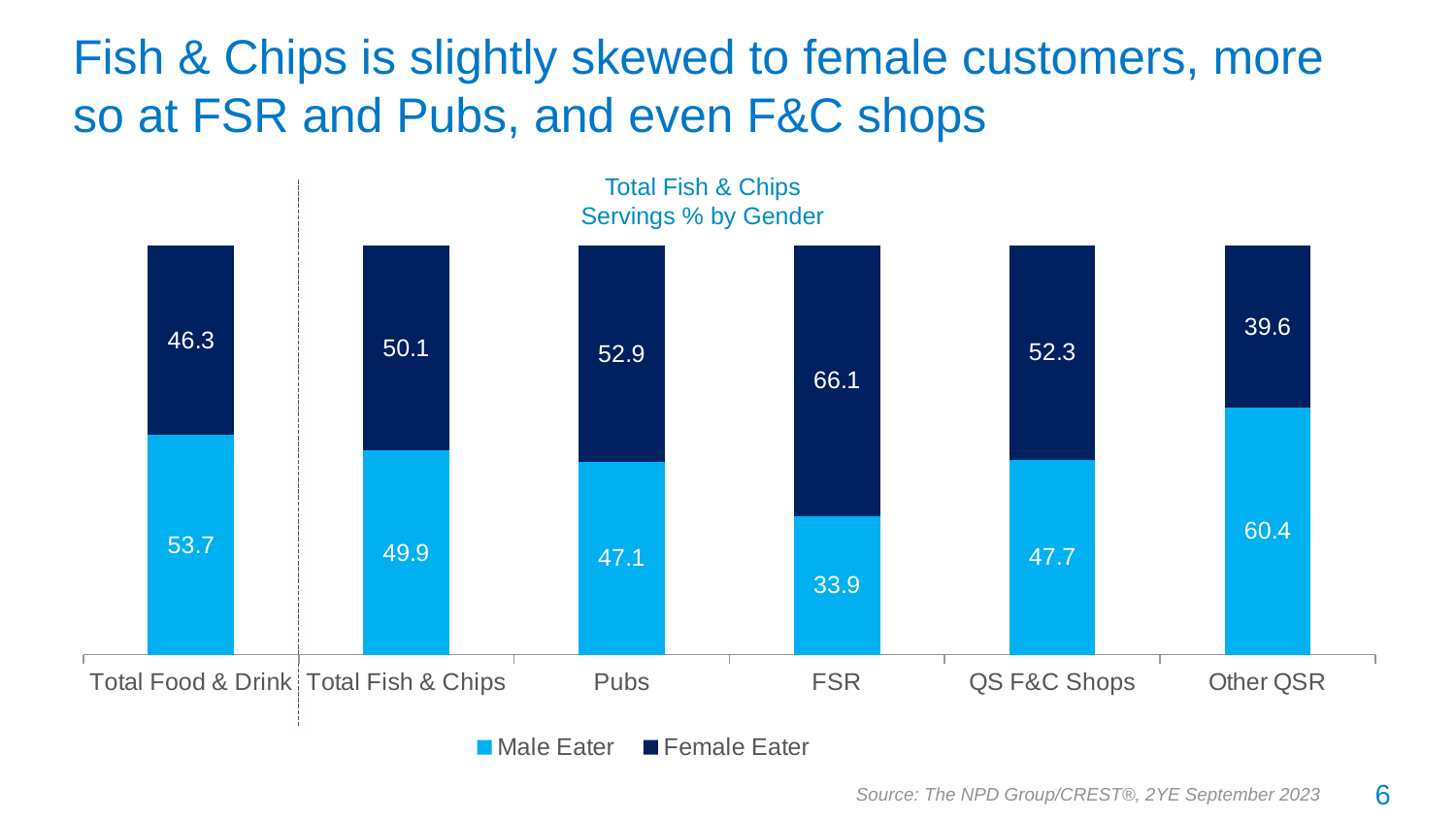
How many series does the legend list? 2 What is the Male Eater value for FSR? 33.9 What is the Female Eater value for Total Fish & Chips? 50.1 What is the Female Eater value for Other QSR? 39.6 What is the difference between the Female Eater and Male Eater values for FSR? 32.2 What is the total of the stacked bar for QS F&C Shops? 100 What is the title of the chart? Total Fish & Chips Servings % by Gender How many categories are shown on the x axis? 6 What kind of chart is shown on the slide? Stacked bar chart Which category has the lowest Male Eater value? FSR Which category has the highest Female Eater value? FSR Which is larger for Pubs, the Male Eater value or the Female Eater value? Female Eater